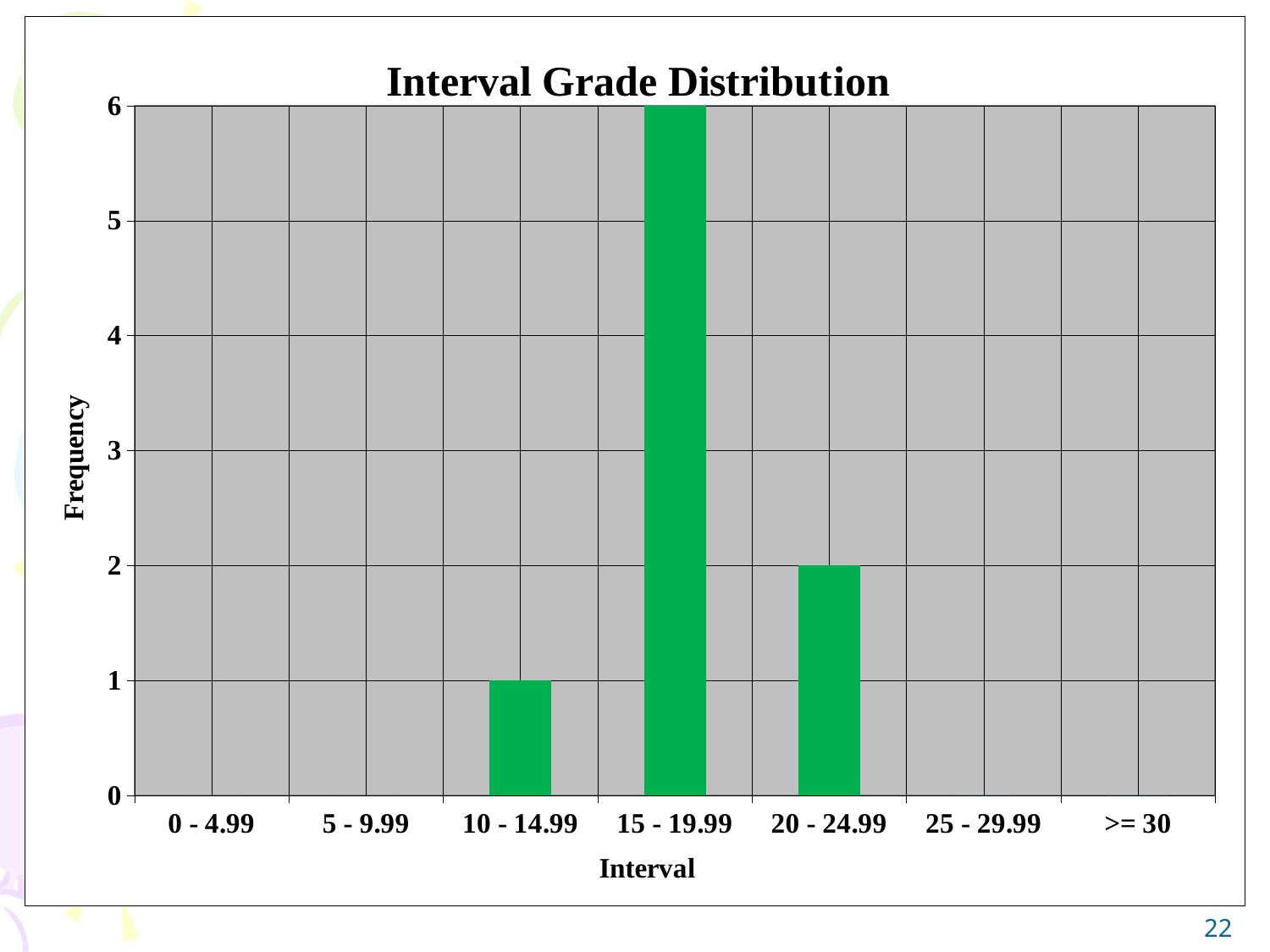
What is the label of the y axis? Frequency Is the frequency for the 15 - 19.99 interval greater or less than 4? greater What is the difference in frequency between the 15 - 19.99 and 20 - 24.99 intervals? 4 What is the frequency for the 15 - 19.99 interval? 6 What is the frequency for the 10 - 14.99 interval? 1 What kind of chart is shown on the slide? bar chart What is the title of the chart? Interval Grade Distribution How many intervals are shown on the x axis? 7 What is the frequency for the 20 - 24.99 interval? 2 Which interval has the highest frequency? 15 - 19.99 Which has a higher frequency, the 10 - 14.99 interval or the 20 - 24.99 interval? 20 - 24.99 What is the frequency for the 0 - 4.99 interval? 0